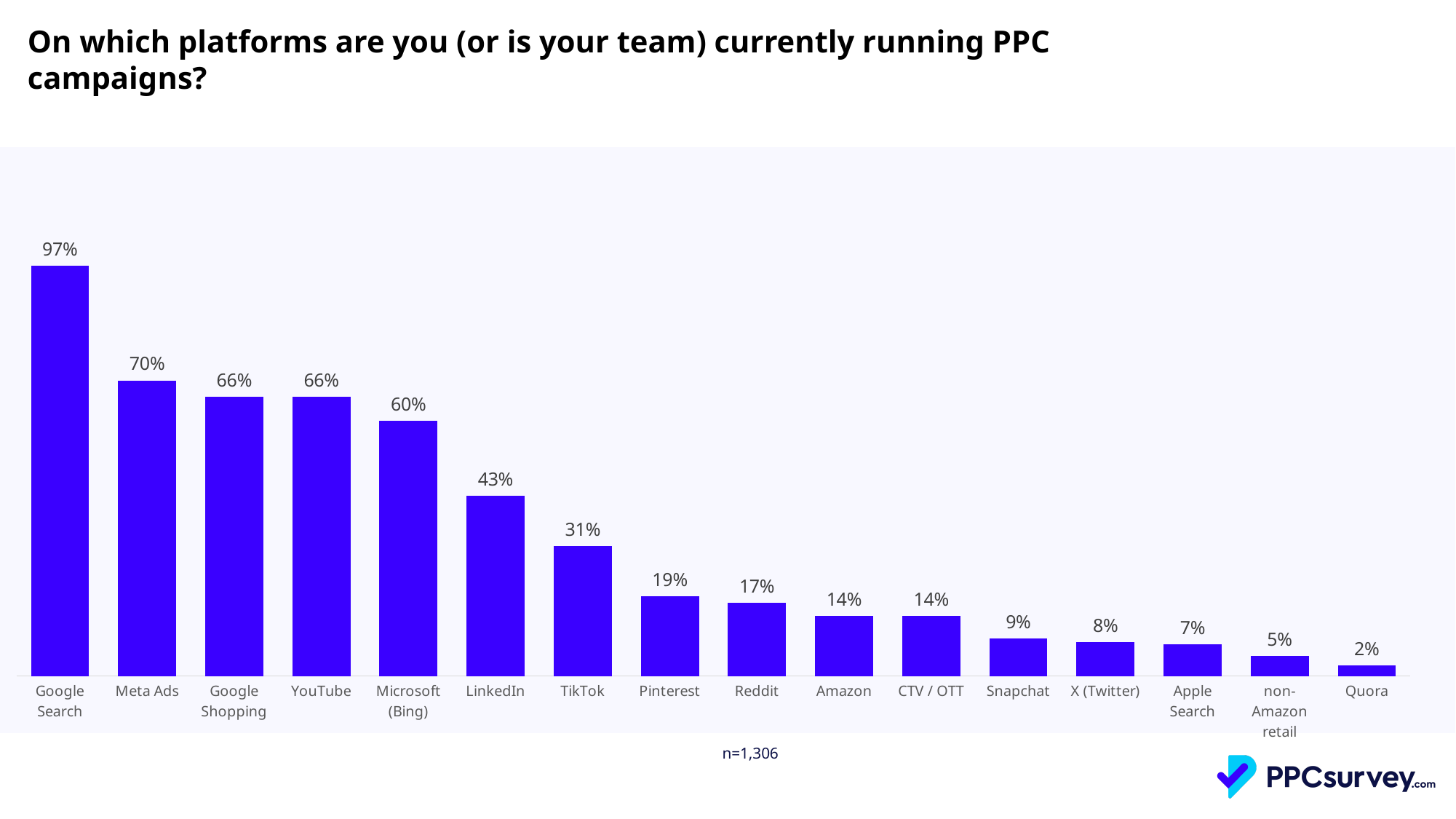
What is the sample size (n) noted below the chart? n=1,306 What is the difference between the values for Google Search and Google Shopping? 31% What is the value shown for Microsoft (Bing)? 60% What is the difference between the values for Meta Ads and LinkedIn? 27% What percentage of respondents run PPC campaigns on Google Search? 97% Which is larger, the value for Pinterest or the value for Reddit? Pinterest Which platform has the highest value? Google Search How many platforms are shown on the chart? 16 What is the value shown for TikTok? 31% Which is larger, the value for Snapchat or the value for Apple Search? Snapchat Which platform has the lowest value? Quora What kind of chart is shown on the slide? Bar chart